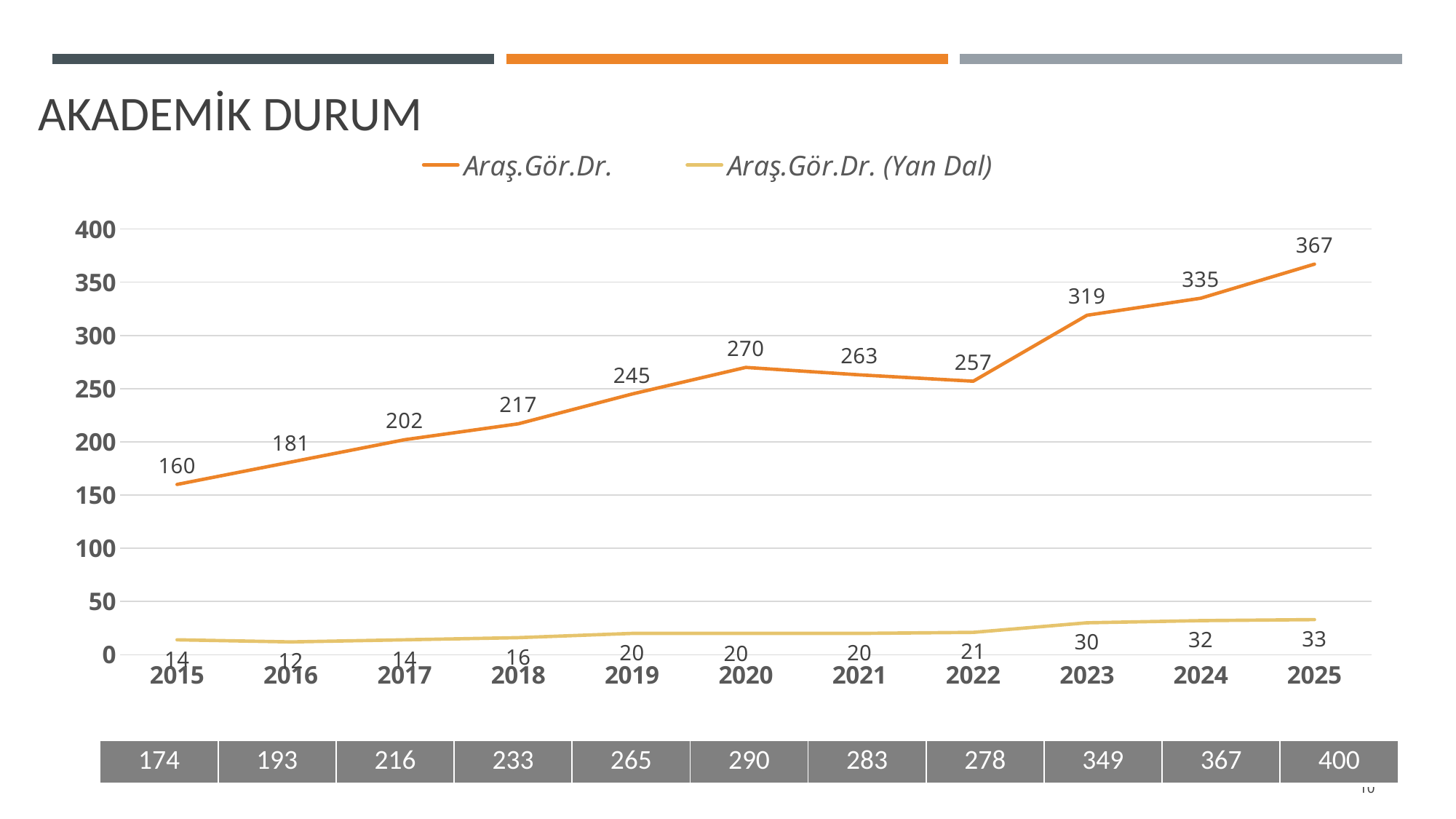
What is the difference between the Araş.Gör.Dr. values for 2025 and 2024? 32 What is the value for Araş.Gör.Dr. in 2020? 270 Does the Araş.Gör.Dr. series rise or fall between 2020 and 2022? fall Is the value for Araş.Gör.Dr. in 2023 greater or less than 300? greater How many series does the legend list? 2 What kind of chart is shown on the slide? line chart What is the value for Araş.Gör.Dr. in 2015? 160 What is the value for Araş.Gör.Dr. (Yan Dal) in 2023? 30 In which year is the Araş.Gör.Dr. (Yan Dal) series lowest? 2016 In which year is the Araş.Gör.Dr. series highest? 2025 How many years are shown on the x axis? 11 Which is larger for Araş.Gör.Dr.: the value in 2021 or the value in 2022? 2021